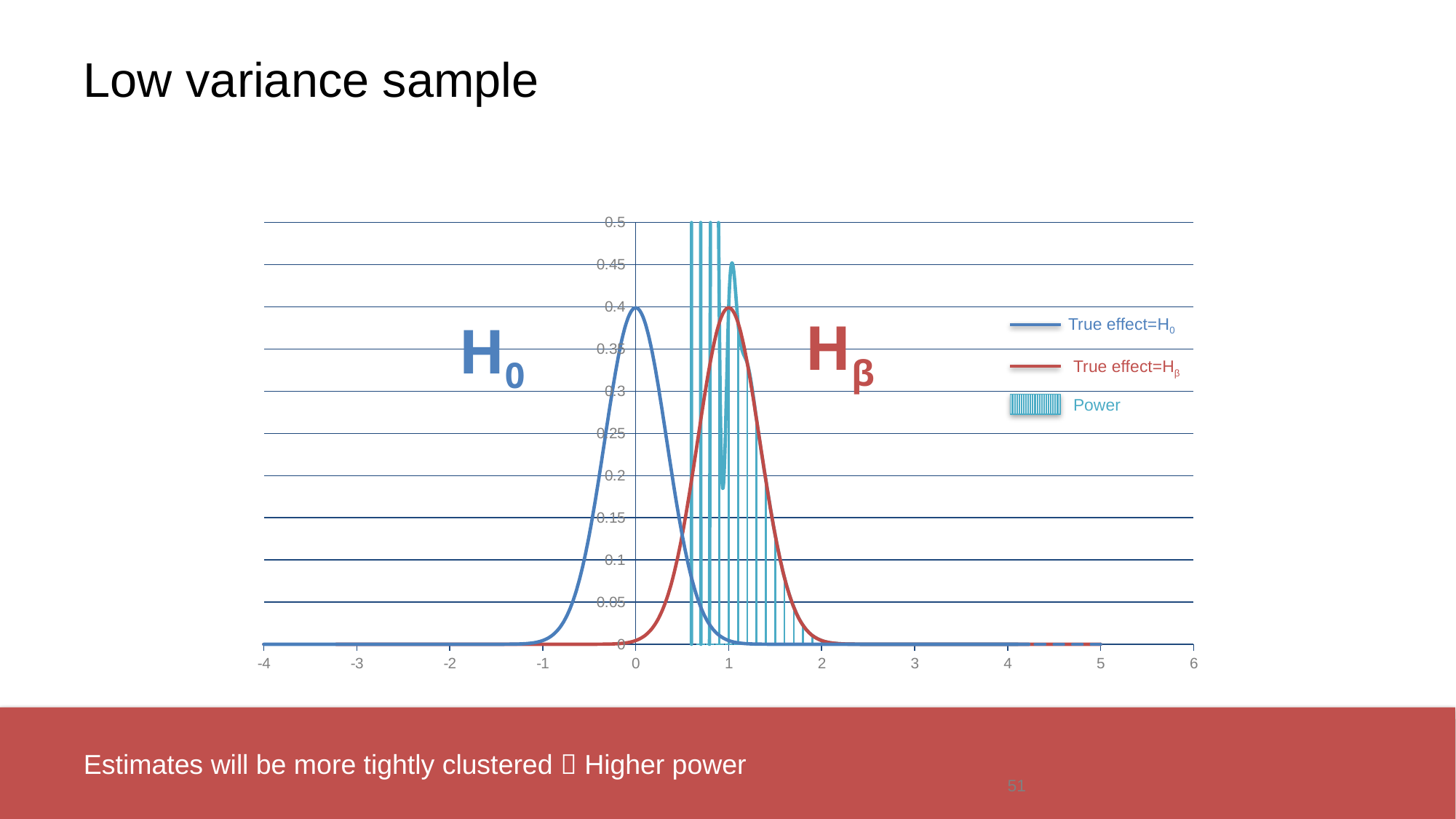
What is the peak value of the True effect=H0 curve? 0.4 What kind of chart is shown on the slide? line chart Is the value of the True effect=H0 curve at x = 2 greater or less than 0.05? less At which x-axis value does the True effect=H0 curve reach its peak? 0 How many series does the legend list? 3 At x = 1, which curve is higher, True effect=H0 or True effect=Hβ? True effect=Hβ At which x-axis value does the True effect=Hβ curve reach its peak? 1 At x = 0, which curve is higher, True effect=H0 or True effect=Hβ? True effect=H0 Does the True effect=H0 curve rise or fall as x goes from 0 to 2? fall What are the three entries in the chart legend? True effect=H0, True effect=Hβ, Power Is the value of the True effect=Hβ curve at x = 1 greater or less than 0.3? greater What is the title of the slide containing the chart? Low variance sample